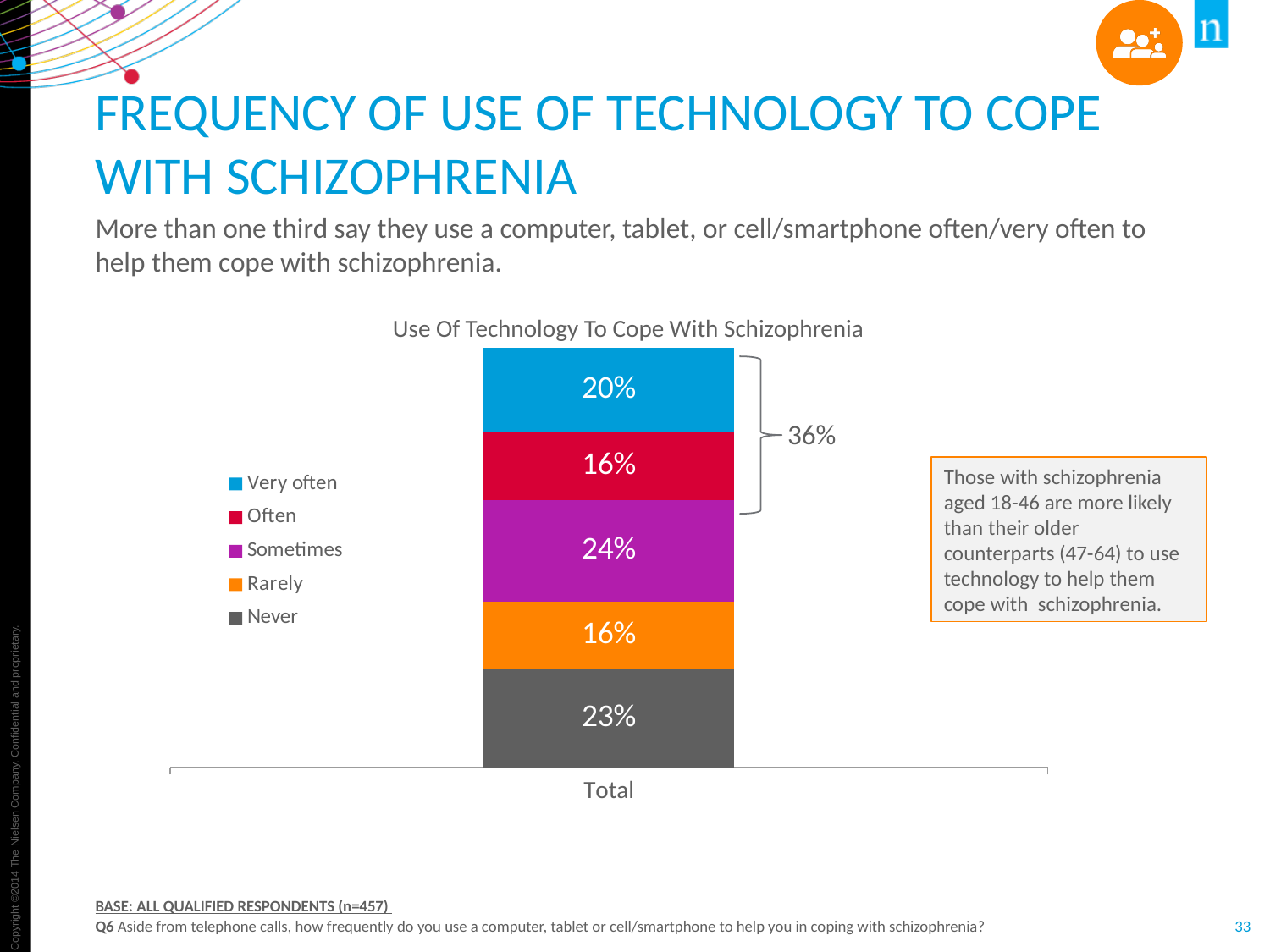
What is the value for Rarely in the Total bar? 16% What is the difference between the Sometimes and Very often values? 4% What is the value for Very often in the Total bar? 20% How many categories are shown on the x axis? 1 What kind of chart is shown? Stacked bar chart What is the value for Never in the Total bar? 23% How many series does the legend list? 5 Which series has the largest segment in the Total bar? Sometimes What is the value for Sometimes in the Total bar? 24% What is the combined value of Very often and Often shown by the bracket? 36% What is the title of the chart? Use Of Technology To Cope With Schizophrenia Which is larger, the Never value or the Very often value? Never